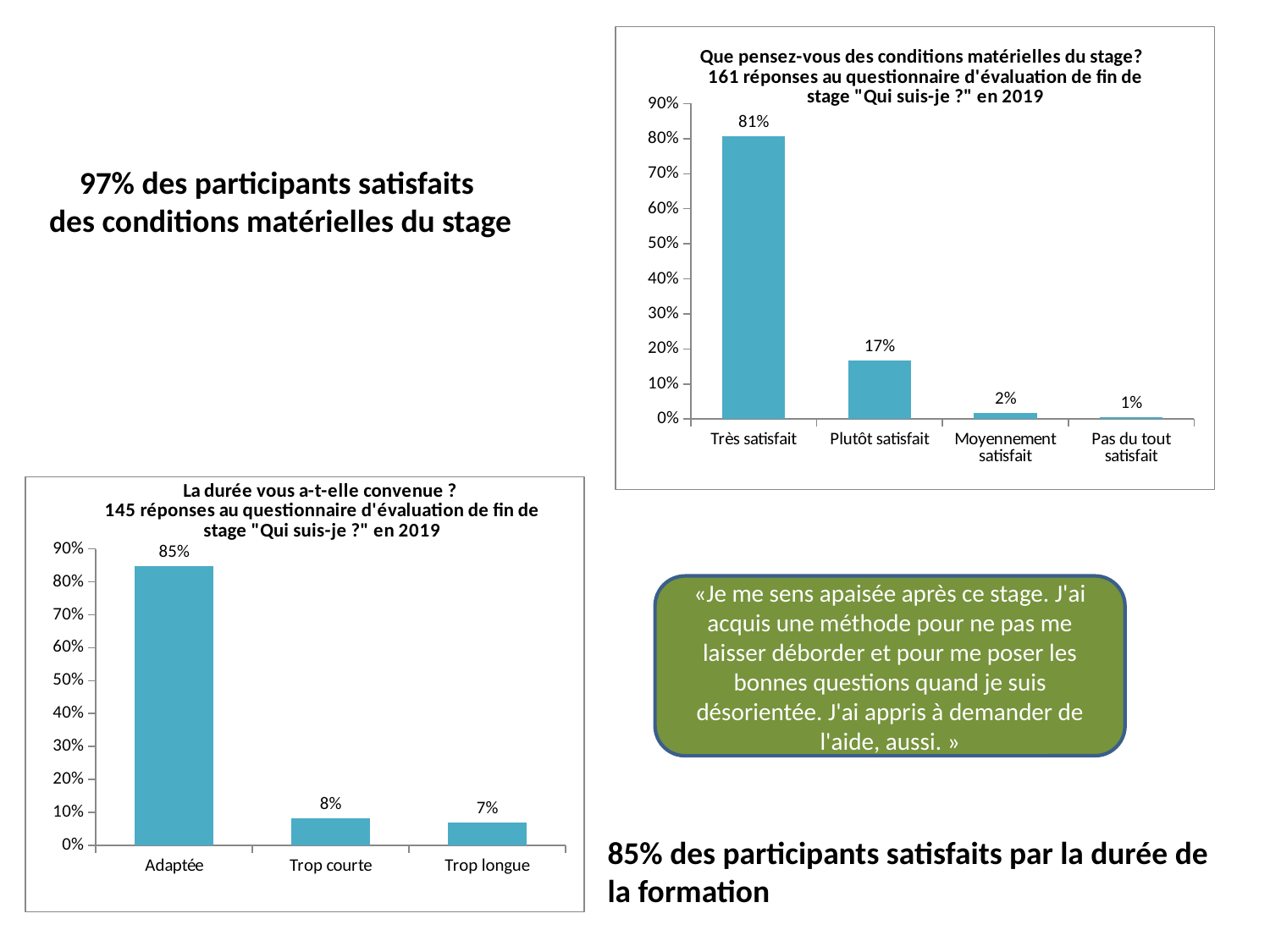
In the top-right chart 'Que pensez-vous des conditions matérielles du stage?', what is the value for 'Plutôt satisfait'? 17% In the top-right chart 'Que pensez-vous des conditions matérielles du stage?', what is the difference between 'Très satisfait' and 'Plutôt satisfait'? 64% What kind of chart is the bottom-left chart 'La durée vous a-t-elle convenue ?'? bar chart In the bottom-left chart 'La durée vous a-t-elle convenue ?', which category has the highest value? Adaptée In the bottom-left chart 'La durée vous a-t-elle convenue ?', which is larger, 'Trop courte' or 'Trop longue'? Trop courte In the top-right chart 'Que pensez-vous des conditions matérielles du stage?', what is the value for 'Très satisfait'? 81% In the top-right chart 'Que pensez-vous des conditions matérielles du stage?', how many categories are shown? 4 In the top-right chart 'Que pensez-vous des conditions matérielles du stage?', do the values rise or fall from left to right? fall In the bottom-left chart 'La durée vous a-t-elle convenue ?', how many categories are shown? 3 In the top-right chart 'Que pensez-vous des conditions matérielles du stage?', which category has the lowest value? Pas du tout satisfait In the bottom-left chart 'La durée vous a-t-elle convenue ?', what is the value for 'Adaptée'? 85% In the bottom-left chart 'La durée vous a-t-elle convenue ?', what is the value for 'Trop longue'? 7%